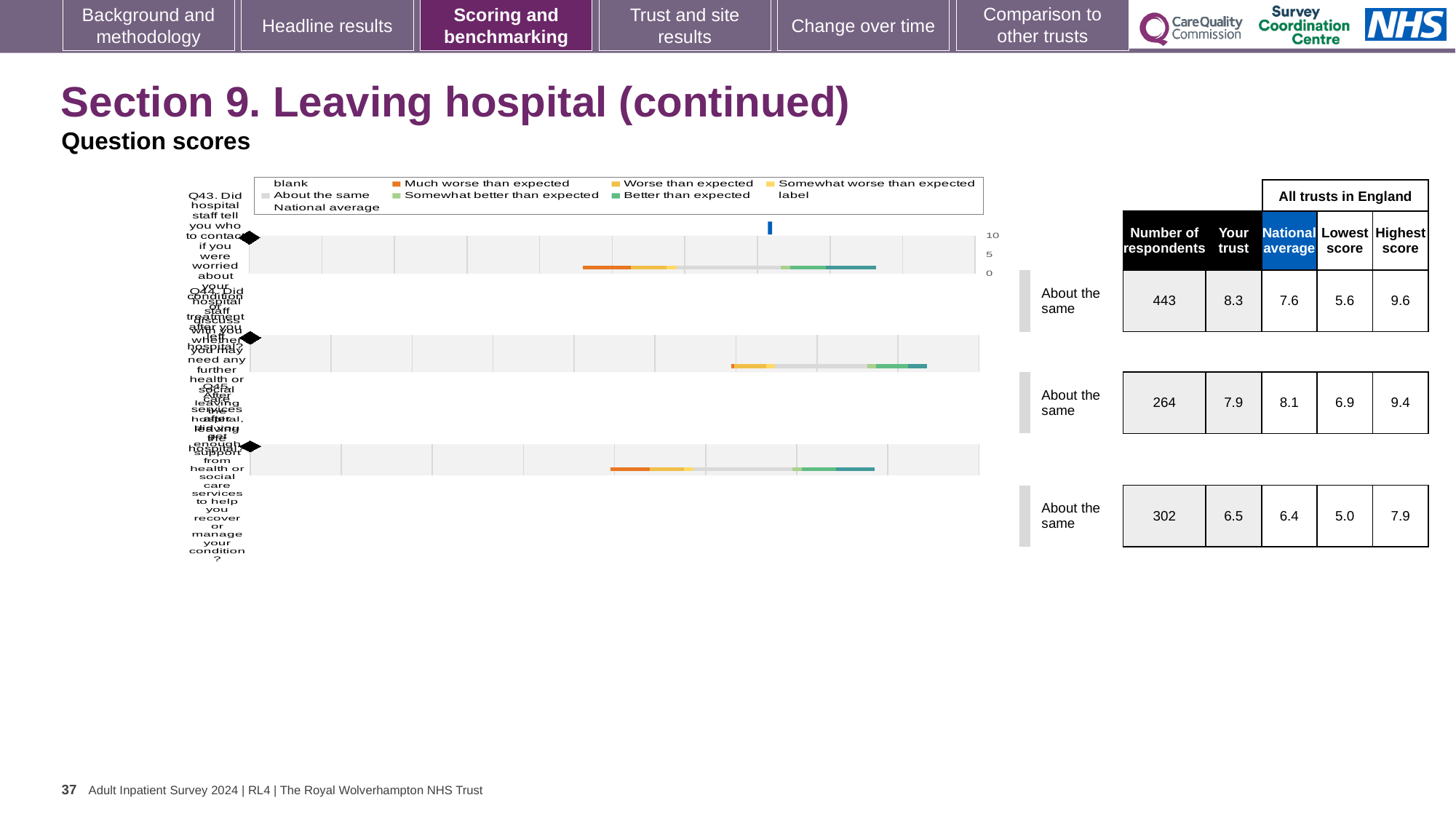
Which of the three charts has the lowest 'Your trust' score? the bottom chart (6.5) For the top chart (Q43), what is the national average score? 7.6 Which of the three charts has the highest 'Your trust' score? the top chart, Q43 (8.3) For the top chart (Q43), what is the difference between the 'Your trust' score and the national average? 0.7 How many benchmark charts are shown on the slide? 3 What kind of chart is used for the Q43 benchmark on the slide? bar chart For the top chart (Q43, who to contact if worried after leaving hospital), what is the 'Your trust' score? 8.3 For the middle chart, what is the 'Your trust' score? 7.9 In the chart legend, what colour represents 'Much worse than expected'? orange For the bottom chart, what is the national average score? 6.4 For the top chart (Q43), which is larger: the 'Your trust' score or the national average? Your trust What benchmark category is shown next to the middle chart? About the same